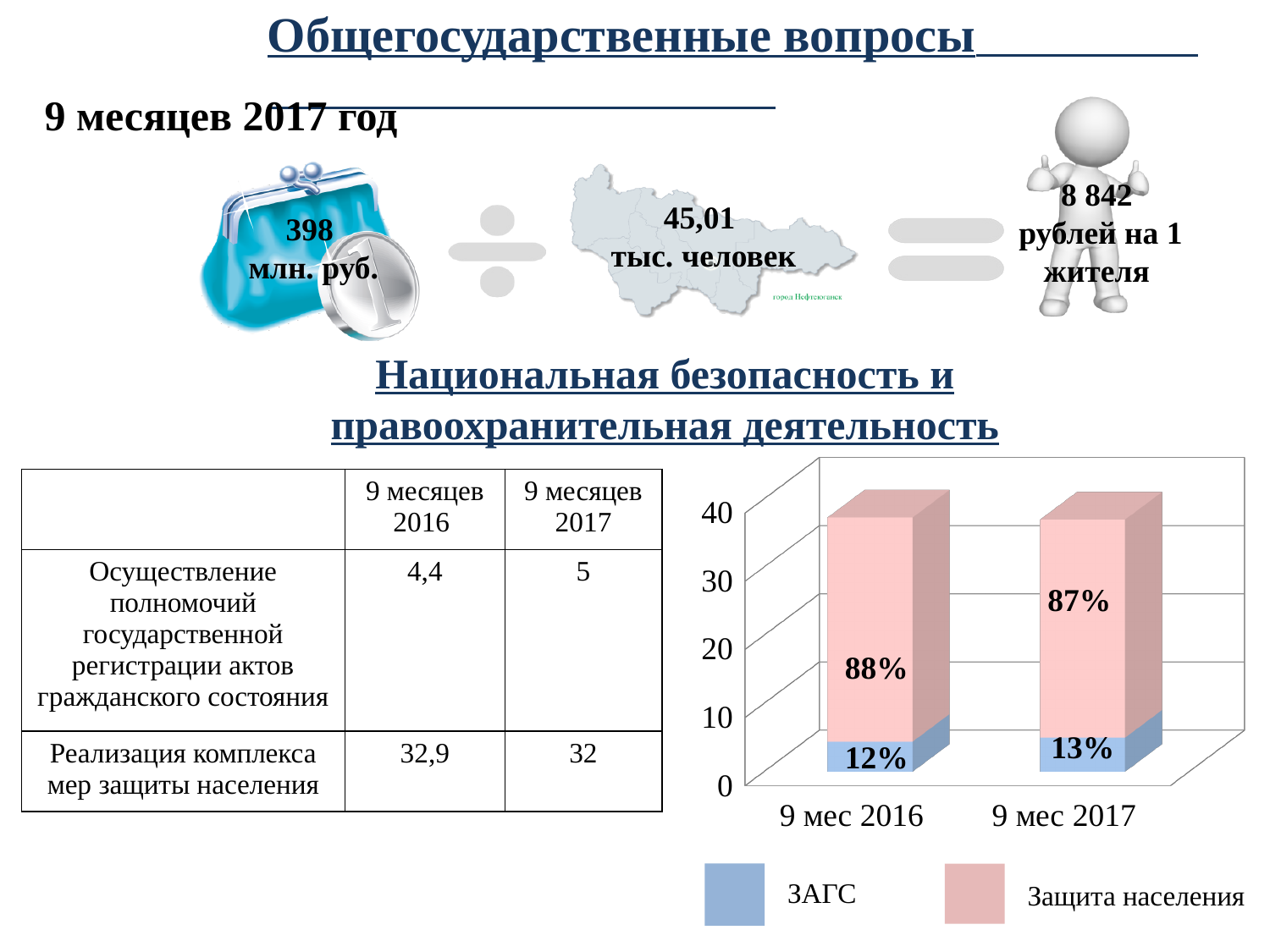
What percentage label is shown for ЗАГС in 9 мес 2016? 12% What percentage label is shown for Защита населения in 9 мес 2017? 87% How many series does the chart legend list? 2 How many categories are shown on the x axis of the chart? 2 What is the difference between the Защита населения labels for 9 мес 2016 and 9 мес 2017? 1% Does the ЗАГС share rise or fall from 9 мес 2016 to 9 мес 2017? rise Which series is shown in pink in the chart legend? Защита населения What kind of chart is shown on the slide? bar chart What percentage label is shown for ЗАГС in 9 мес 2017? 13% Which series has the larger share in 9 мес 2016, ЗАГС or Защита населения? Защита населения What percentage label is shown for Защита населения in 9 мес 2016? 88%